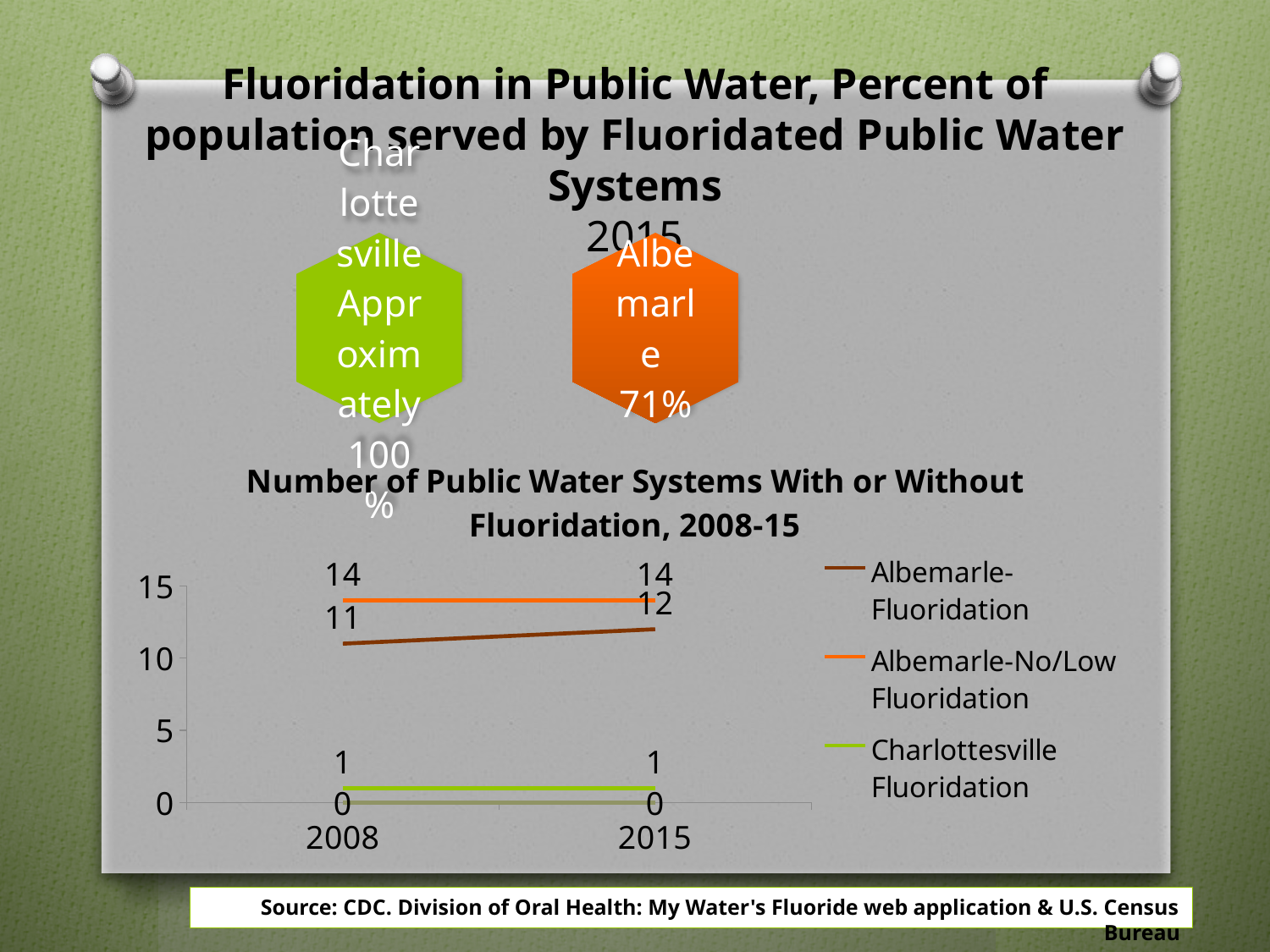
In the top chart 'Fluoridation in Public Water, Percent of population served by Fluoridated Public Water Systems', what percent is shown for Albemarle? 71% In the line chart 'Number of Public Water Systems With or Without Fluoridation, 2008-15', how many series does the legend list? 3 In the line chart 'Number of Public Water Systems With or Without Fluoridation, 2008-15', which is larger in 2015: Albemarle-Fluoridation or Charlottesville Fluoridation? Albemarle-Fluoridation In the line chart 'Number of Public Water Systems With or Without Fluoridation, 2008-15', what is the value for Albemarle-Fluoridation in 2008? 11 In the line chart 'Number of Public Water Systems With or Without Fluoridation, 2008-15', what is the value for Charlottesville Fluoridation in 2008? 1 In the line chart 'Number of Public Water Systems With or Without Fluoridation, 2008-15', how many years are shown on the x axis? 2 In the line chart 'Number of Public Water Systems With or Without Fluoridation, 2008-15', which series has the highest value in 2015? Albemarle-No/Low Fluoridation In the line chart 'Number of Public Water Systems With or Without Fluoridation, 2008-15', what is the value for Albemarle-Fluoridation in 2015? 12 In the line chart 'Number of Public Water Systems With or Without Fluoridation, 2008-15', what is the difference between Albemarle-No/Low Fluoridation and Albemarle-Fluoridation in 2008? 3 In the line chart 'Number of Public Water Systems With or Without Fluoridation, 2008-15', does the Albemarle-Fluoridation series rise or fall from 2008 to 2015? rise In the line chart 'Number of Public Water Systems With or Without Fluoridation, 2008-15', what is the value for Albemarle-No/Low Fluoridation in 2015? 14 What kind of chart is 'Number of Public Water Systems With or Without Fluoridation, 2008-15'? line chart